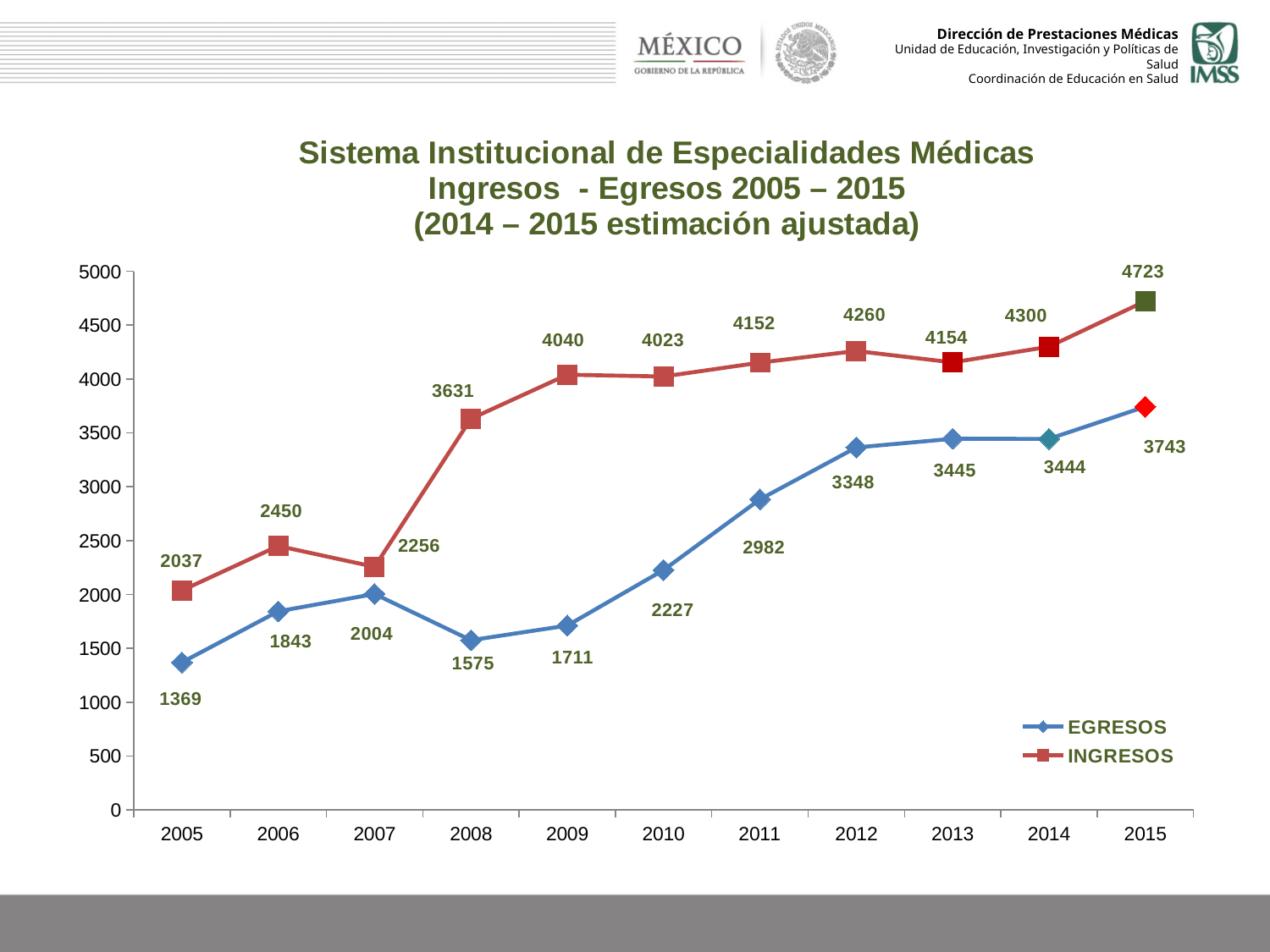
What is the difference between INGRESOS and EGRESOS in 2015? 980 How many series does the legend list? 2 How many years are shown on the x axis? 11 What is the INGRESOS value for 2008? 3631 What is the difference between the INGRESOS values for 2008 and 2007? 1375 What type of chart is shown on the slide? line chart Which is larger, the EGRESOS value for 2013 or the EGRESOS value for 2010? 2013 Does the INGRESOS series generally rise or fall from 2005 to 2015? rise Which series is drawn in red? INGRESOS In which year is the EGRESOS value lowest? 2005 In which year is the INGRESOS value highest? 2015 What is the EGRESOS value for 2011? 2982